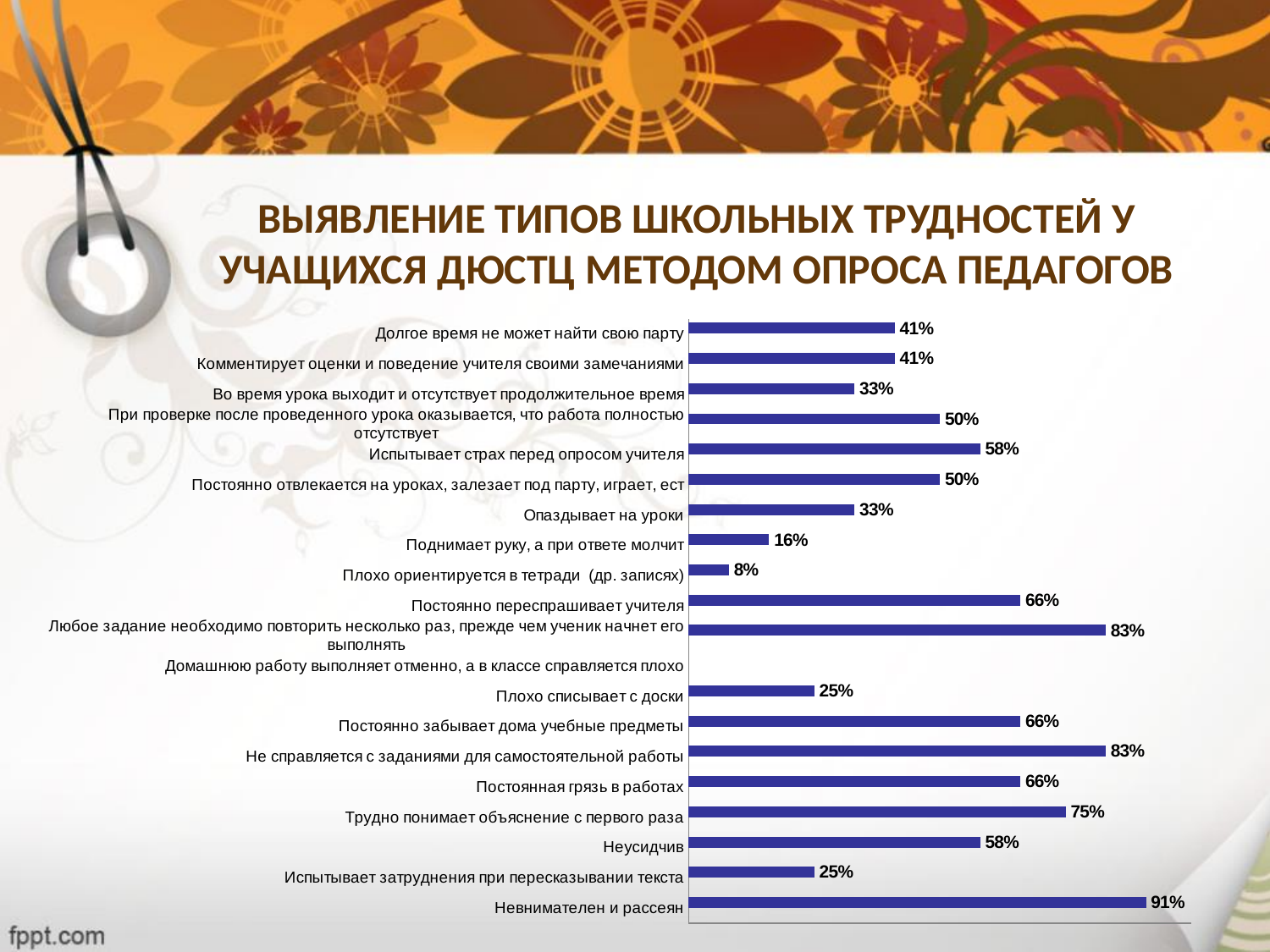
What is the value for "Поднимает руку, а при ответе молчит"? 16% What is the value for "Опаздывает на уроки"? 33% What is the value for "Плохо ориентируется в тетради (др. записях)"? 8% What type of chart is shown on the slide? bar chart What is the difference between the values for "Постоянно переспрашивает учителя" and "Плохо списывает с доски"? 41% What is the title of the slide containing the chart? ВЫЯВЛЕНИЕ ТИПОВ ШКОЛЬНЫХ ТРУДНОСТЕЙ У УЧАЩИХСЯ ДЮСТЦ МЕТОДОМ ОПРОСА ПЕДАГОГОВ How many categories are listed on the chart? 20 What is the value for "Трудно понимает объяснение с первого раза"? 75% Which is larger: the value for "Испытывает страх перед опросом учителя" or the value for "Во время урока выходит и отсутствует продолжительное время"? Испытывает страх перед опросом учителя Which category has the highest value? Невнимателен и рассеян What is the value for "Невнимателен и рассеян"? 91% What is the difference between the values for "Невнимателен и рассеян" and "Неусидчив"? 33%